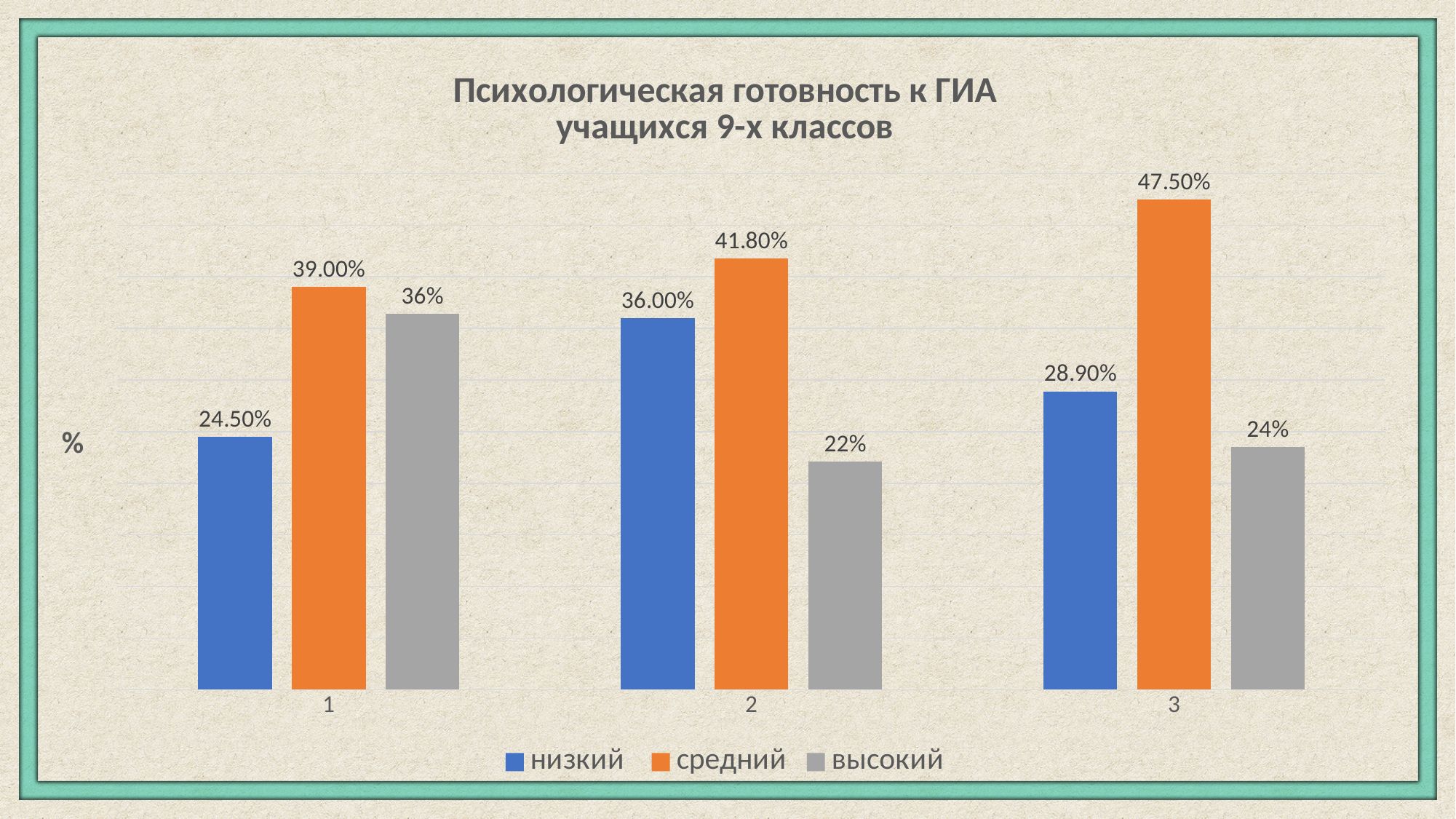
Which category has the highest value for средний? 3 What is the value for высокий in category 2? 22% What kind of chart is shown on the slide? bar chart Which category has the lowest value for низкий? 1 What is the value for средний in category 3? 47.50% What is the title of the chart? Психологическая готовность к ГИА учащихся 9-х классов Which is larger in category 1: средний or высокий? средний How many series does the legend list? 3 What is the value for средний in category 2? 41.80% What is the difference between средний and низкий in category 3? 18.60% How many categories are shown on the x axis? 3 What is the value for низкий in category 1? 24.50%